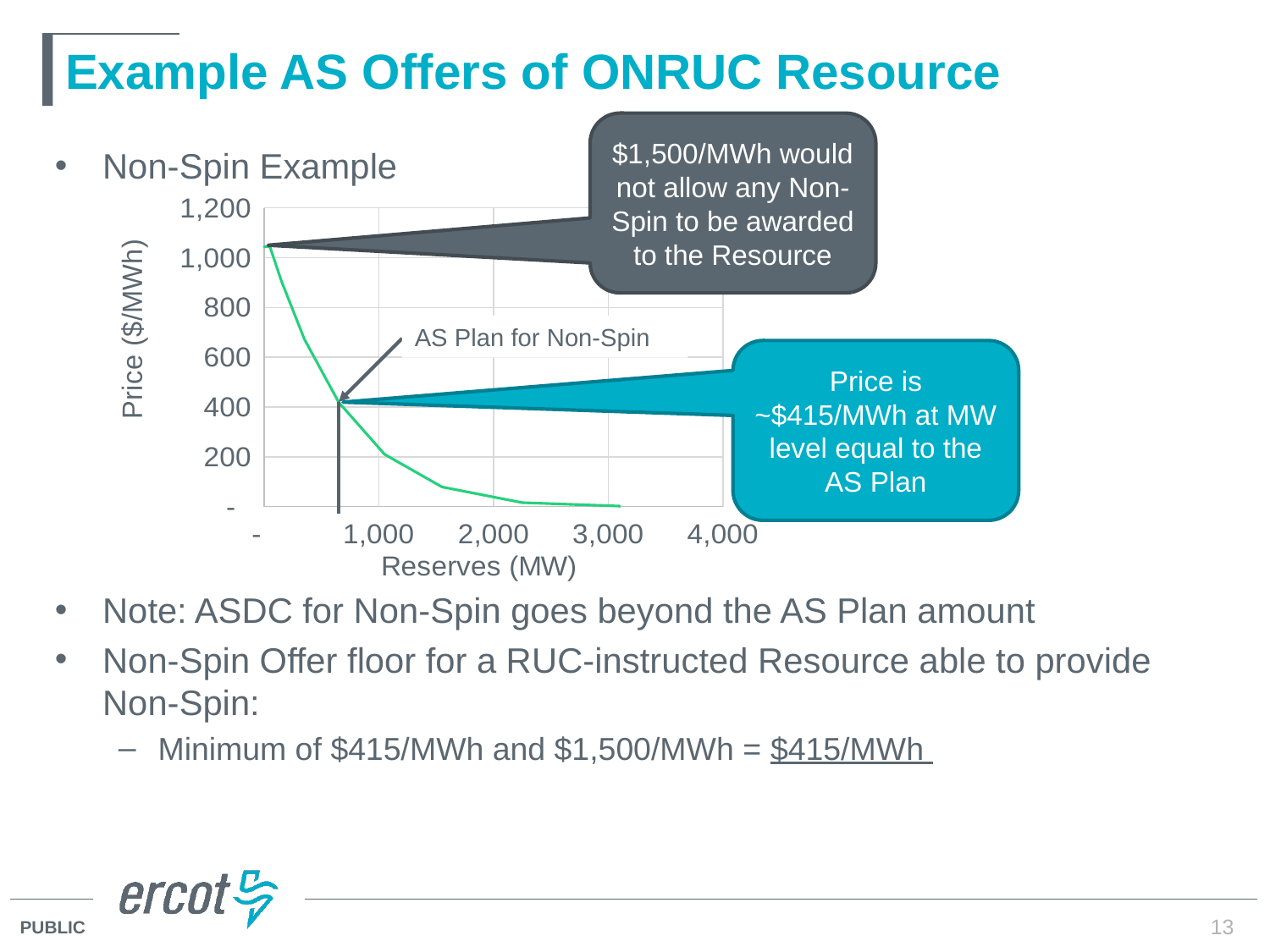
What is the title of the y axis of the chart? Price ($/MWh) Is the price at 1,000 MW of reserves greater or less than 400 $/MWh? less As reserves increase along the x axis, does the price curve rise or fall? Fall What is the highest tick value shown on the x axis of the chart? 4,000 Which is higher on the curve: the price at 500 MW of reserves or the price at 1,500 MW of reserves? 500 MW What is the highest tick value shown on the y axis of the chart? 1,200 How many data series are plotted on the chart? 1 Is the price at 2,000 MW of reserves greater or less than 200 $/MWh? less What kind of chart is shown on the slide? Line chart Is the price at 3,000 MW of reserves greater or less than 200 $/MWh? less